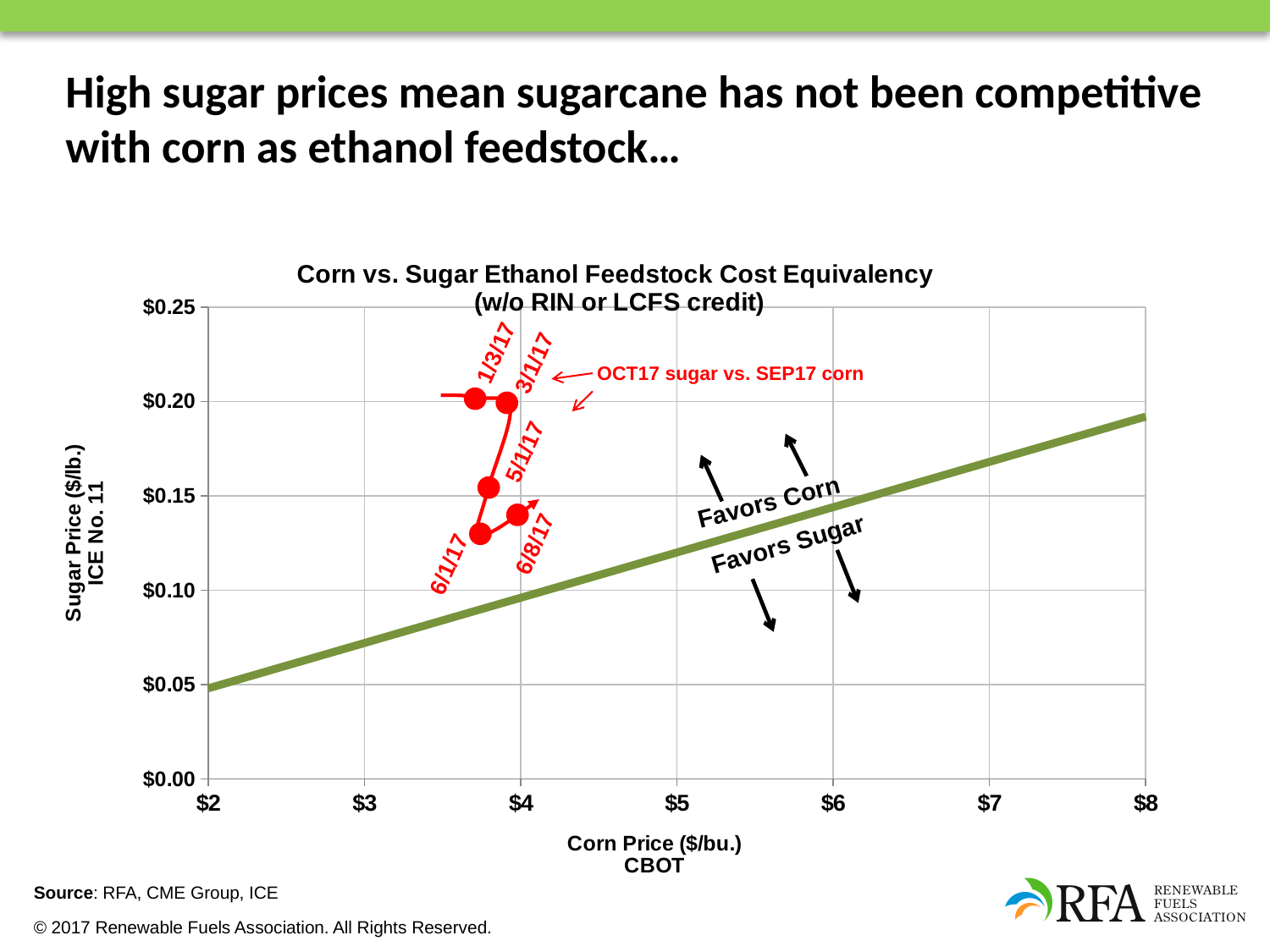
Is the sugar price for the 1/3/17 point greater or less than $0.15? greater Which point has the higher sugar price, 3/1/17 or 5/1/17? 3/1/17 What kind of chart is shown on the slide? Line chart What is the label of the x axis? Corn Price ($/bu.) CBOT What is the title of the chart? Corn vs. Sugar Ethanol Feedstock Cost Equivalency (w/o RIN or LCFS credit) Is the value of the green equivalency line at a corn price of $5 greater or less than $0.10? greater How many dated red data points are plotted on the chart? 5 Is the sugar price for the 6/1/17 point greater or less than $0.15? less Do the dated red points lie in the 'Favors Corn' region or the 'Favors Sugar' region of the chart? Favors Corn Does the green equivalency line rise or fall as corn price increases along the x axis? Rises Which point has the higher sugar price, 1/3/17 or 6/1/17? 1/3/17